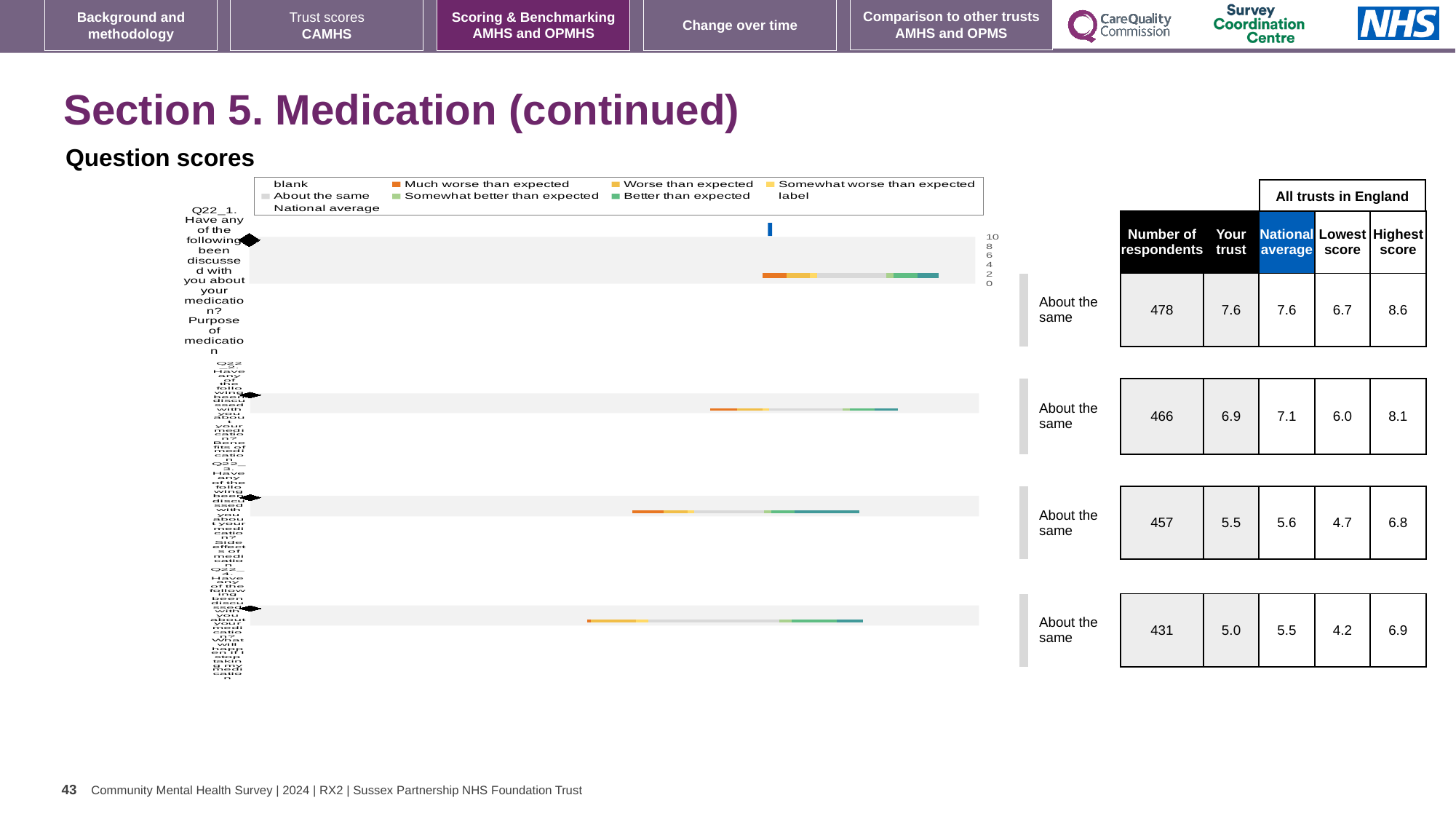
Which colour in the chart legend represents 'Much worse than expected'? orange What kind of chart is used to show the question scores on this slide? bar chart According to the table next to the chart, what is the 'Your trust' score for Q22_1 (Purpose of medication)? 7.6 What is the difference between the highest score (8.6) and the lowest score (6.7) for Q22_1 in the table next to the chart? 1.9 According to the table next to the chart, what is the national average for Q22_2 (Benefits of medication)? 7.1 Which question has the lowest 'Your trust' score in the table next to the chart? Q22_4 (What will happen if I stop taking my medication) How many questions (bars) are plotted in the question scores chart? 4 Which question has the highest 'Your trust' score in the table next to the chart? Q22_1 (Purpose of medication) According to the table next to the chart, how many respondents answered Q22_4 (What will happen if I stop taking my medication)? 431 According to the table next to the chart, what is the lowest score among all trusts in England for Q22_3 (Side effects of medication)? 4.7 Is the 'Your trust' score for Q22_2 (6.9) larger or smaller than the national average (7.1)? smaller What is the highest value shown on the chart's axis? 10